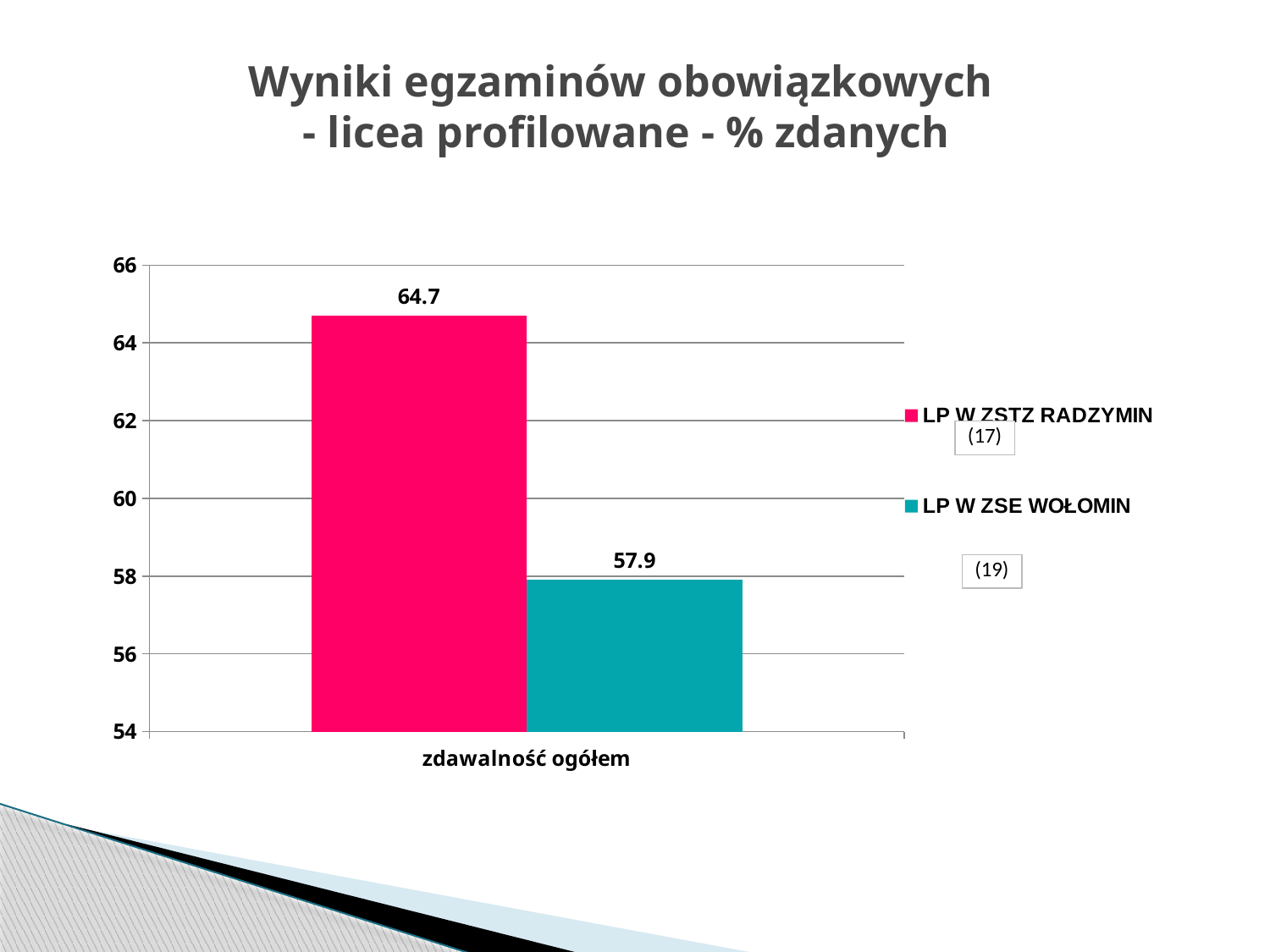
Which series has the lower value? LP W ZSE WOŁOMIN What is the value for LP W ZSE WOŁOMIN? 57.9 Is the value for LP W ZSTZ RADZYMIN larger or smaller than the value for LP W ZSE WOŁOMIN? larger Is the value for LP W ZSTZ RADZYMIN greater or less than 64? greater Is the value for LP W ZSE WOŁOMIN greater or less than 60? less Which series has the higher value? LP W ZSTZ RADZYMIN What is the value for LP W ZSTZ RADZYMIN? 64.7 How many categories are shown on the x axis? 1 What is the label of the category on the x axis? zdawalność ogółem What kind of chart is shown on the slide? bar chart How many series does the legend list? 2 What is the difference between the values for LP W ZSTZ RADZYMIN and LP W ZSE WOŁOMIN? 6.8